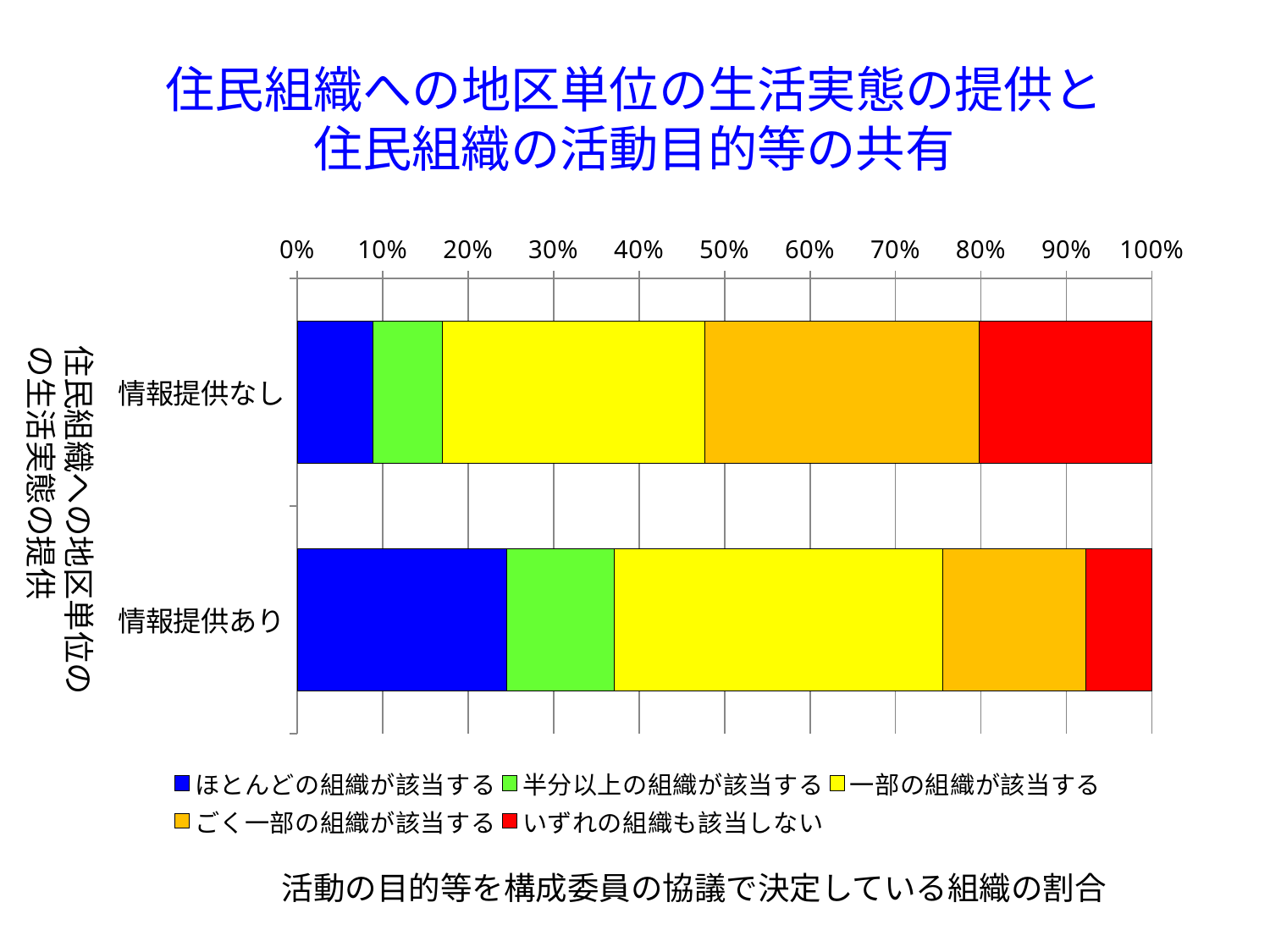
Which category has the larger share for ほとんどの組織が該当する, 情報提供なし or 情報提供あり? 情報提供あり Is the share of いずれの組織も該当しない for 情報提供あり greater or less than 10%? less Is the share of ほとんどの組織が該当する for 情報提供あり greater or less than 20%? greater How many categories (bars) are plotted in the chart? 2 Is the share of ほとんどの組織が該当する for 情報提供なし greater or less than 10%? less What is the label shown below the chart describing the horizontal axis? 活動の目的等を構成委員の協議で決定している組織の割合 Which category has the larger share for ごく一部の組織が該当する, 情報提供なし or 情報提供あり? 情報提供なし Which legend entry is shown in red? いずれの組織も該当しない What kind of chart is shown on the slide? Stacked bar chart Which category has the larger share for いずれの組織も該当しない, 情報提供なし or 情報提供あり? 情報提供なし How many series does the legend list? 5